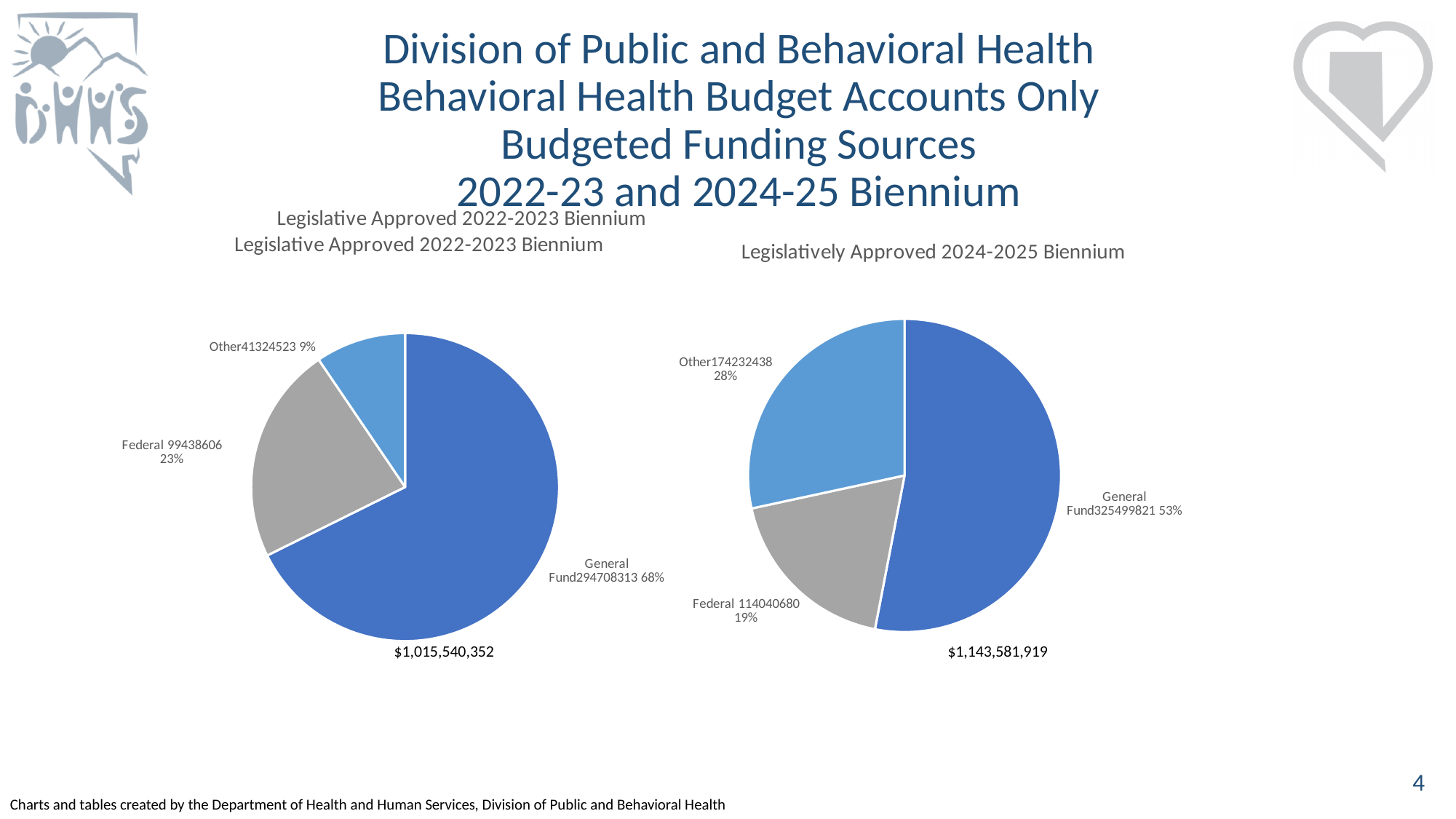
In the Legislatively Approved 2024-2025 Biennium chart, what percentage share does Other have? 28% What kind of chart is the Legislative Approved 2022-2023 Biennium chart? pie chart In the Legislative Approved 2022-2023 Biennium chart, what colour is the Federal slice? grey In the Legislative Approved 2022-2023 Biennium chart, what value is shown for Other? 41324523 In the Legislatively Approved 2024-2025 Biennium chart, which is larger, Federal or Other? Other In the Legislative Approved 2022-2023 Biennium chart, which funding source is the smallest? Other In the Legislatively Approved 2024-2025 Biennium chart, which funding source is the largest? General Fund In the Legislatively Approved 2024-2025 Biennium chart, what value is shown for General Fund? 325499821 In the Legislative Approved 2022-2023 Biennium chart, what percentage share does General Fund have? 68% In the Legislative Approved 2022-2023 Biennium chart, what value is shown for Federal? 99438606 In the Legislatively Approved 2024-2025 Biennium chart, what is the difference between the Other value and the Federal value? 60191758 How many slices does the Legislative Approved 2022-2023 Biennium pie chart have? 3